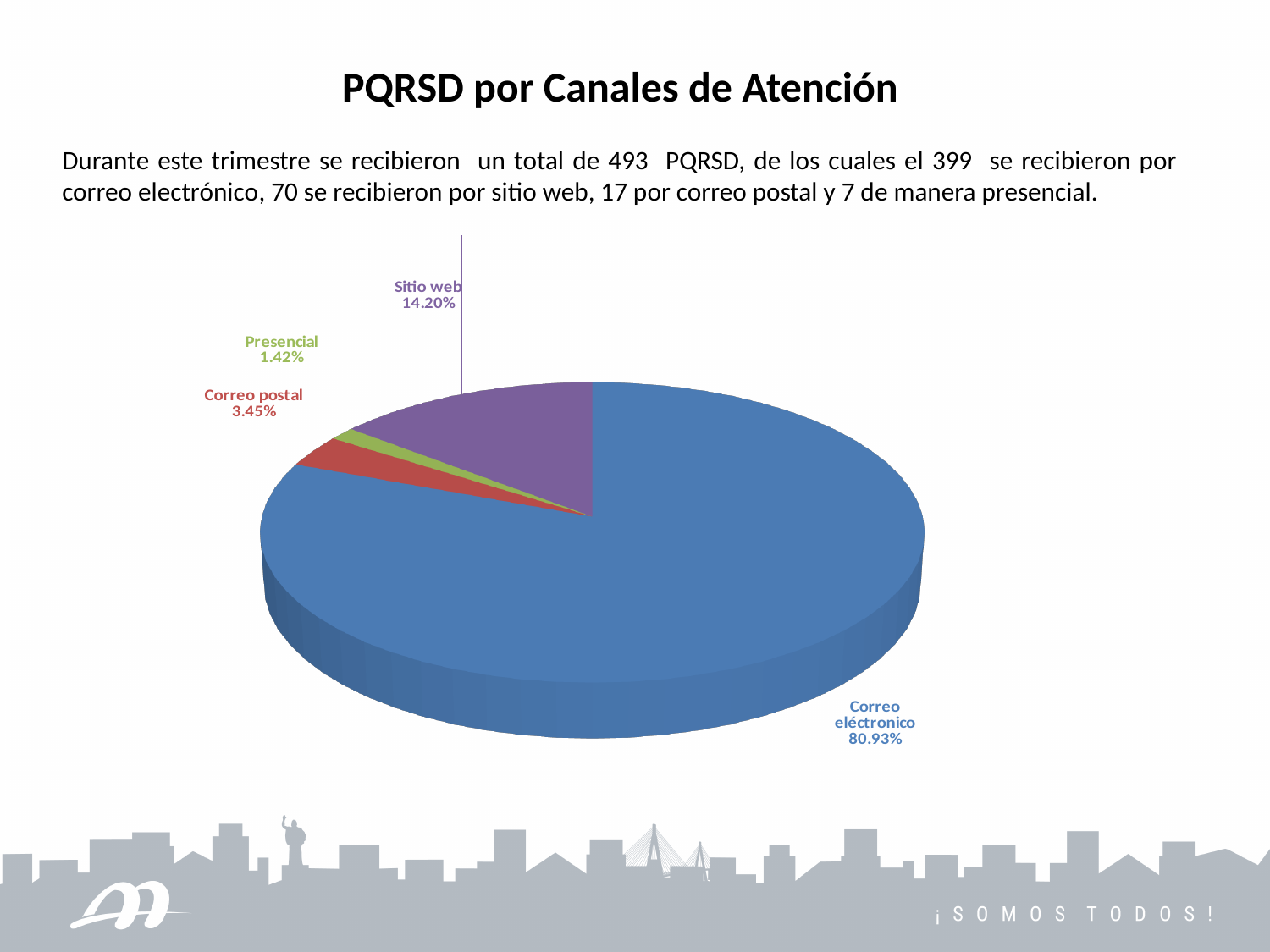
What kind of chart is shown on the slide? pie chart What share of the pie does Sitio web represent? 14.20% What is the difference in percentage points between the Correo eléctronico share and the Sitio web share? 66.73 Which category has the largest slice of the pie? Correo eléctronico What colour is the Sitio web slice of the pie? purple Which category has the smallest slice of the pie? Presencial How many categories are shown in the pie chart? 4 Which is larger, the share for Sitio web or the share for Correo postal? Sitio web What is the title of the chart on the slide? PQRSD por Canales de Atención What share of the pie does Presencial represent? 1.42% What share of the pie does Correo postal represent? 3.45%